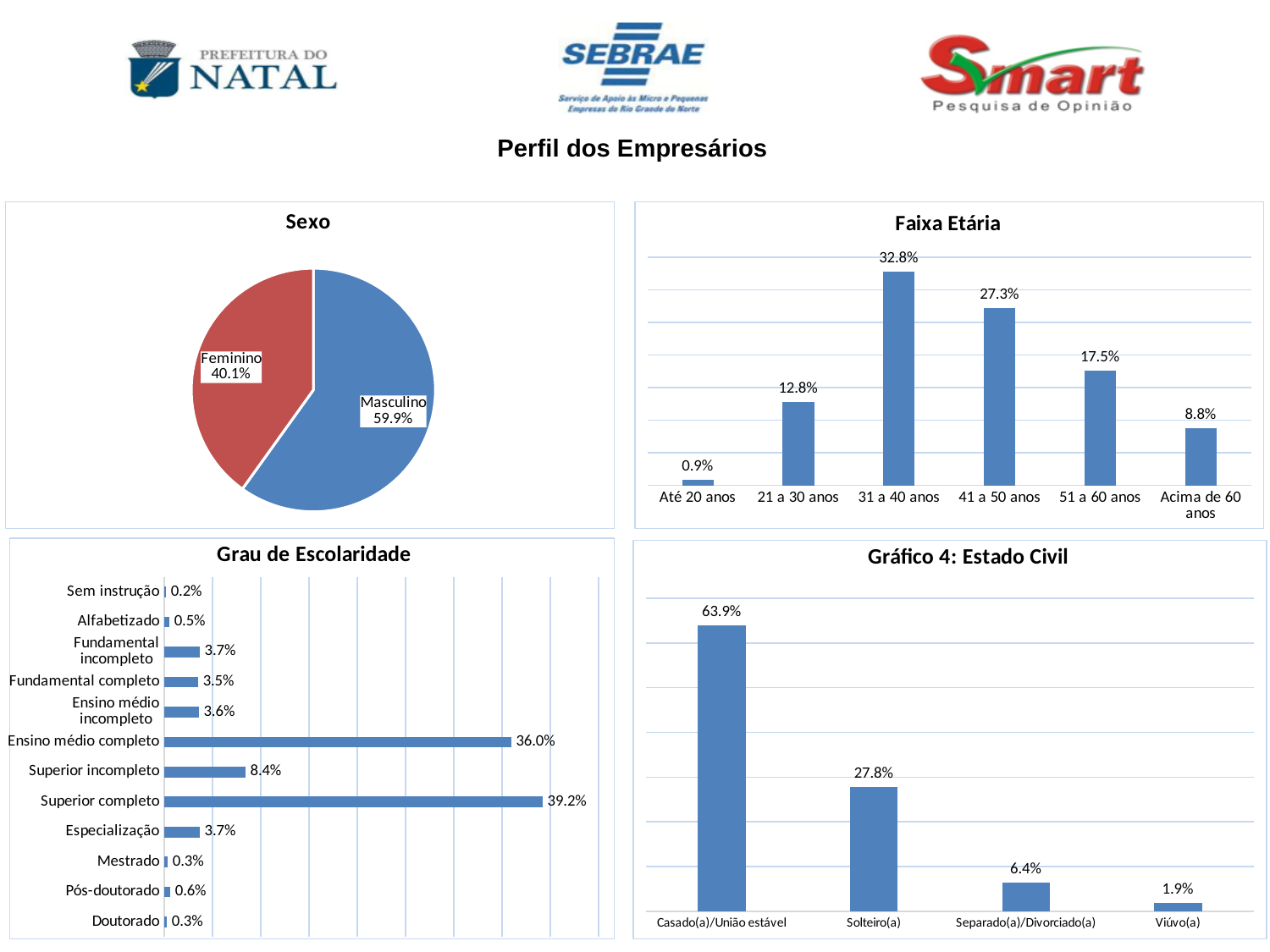
In the 'Faixa Etária' chart, what is the value for 41 a 50 anos? 27.3% In the 'Gráfico 4: Estado Civil' chart, what is the difference between Casado(a)/União estável and Solteiro(a)? 36.1% In the 'Sexo' chart, what share is Masculino? 59.9% In the 'Faixa Etária' chart, what is the difference between 31 a 40 anos and 21 a 30 anos? 20.0% In the 'Faixa Etária' chart, which age group has the lowest value? Até 20 anos In the 'Grau de Escolaridade' chart, which is larger: Ensino médio completo or Superior completo? Superior completo In the 'Grau de Escolaridade' chart, what is the value for Superior incompleto? 8.4% In the 'Grau de Escolaridade' chart, which category has the highest value? Superior completo What kind of chart is the 'Sexo' chart? pie chart How many categories does the 'Faixa Etária' chart show? 6 In the 'Gráfico 4: Estado Civil' chart, what is the value for Solteiro(a)? 27.8% In the 'Faixa Etária' chart, which age group has the highest value? 31 a 40 anos